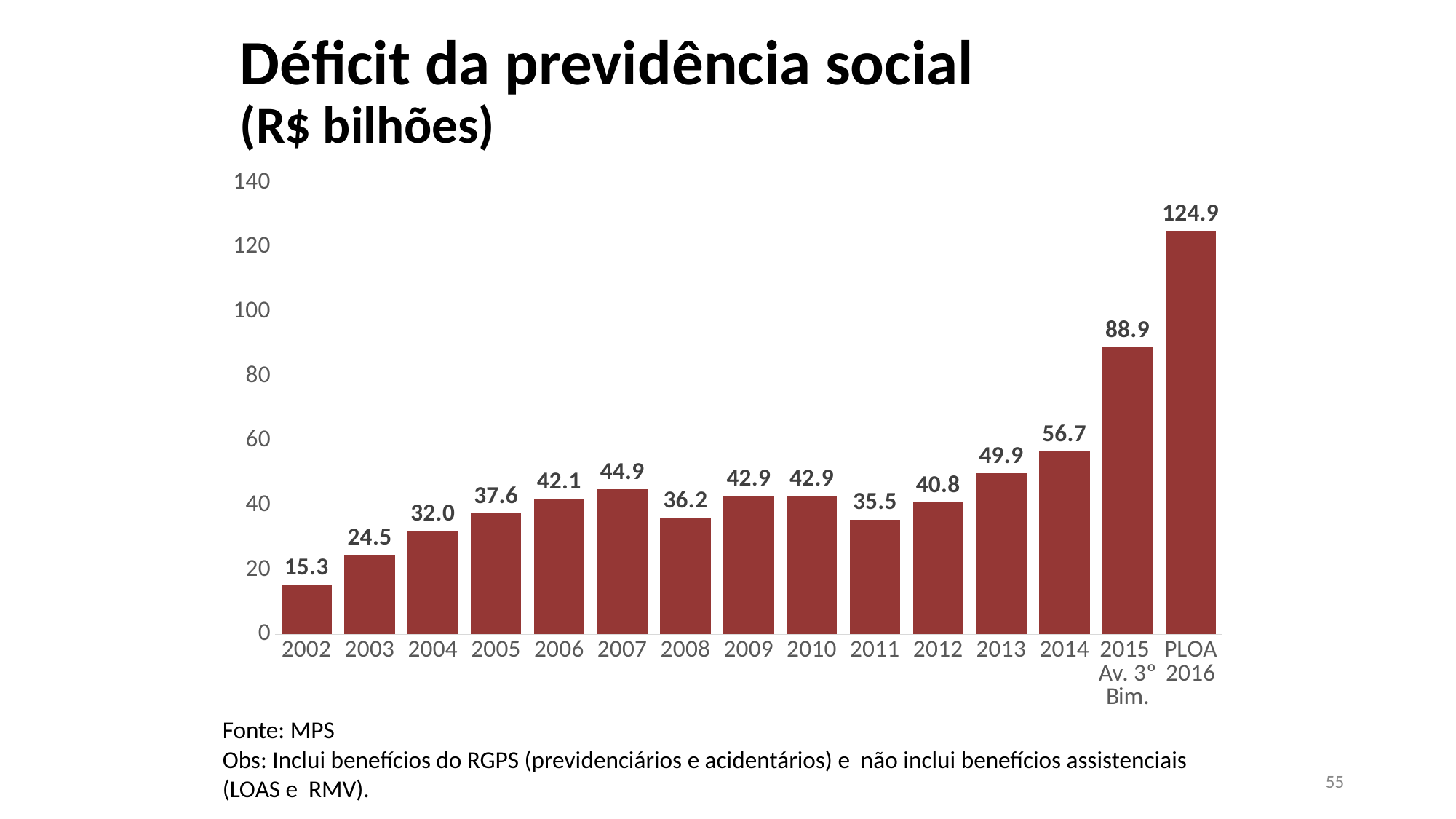
Is the value for 2014 greater or less than 60? less Which category has the lowest value? 2002 What kind of chart is shown on the slide? bar chart What is the difference between the values for PLOA 2016 and 2015 Av. 3° Bim.? 36.0 What is the value for 2015 Av. 3° Bim.? 88.9 Do the values rise or fall from 2012 to PLOA 2016? rise How many bars are shown in the chart? 15 What is the value for PLOA 2016? 124.9 Which category has the highest value? PLOA 2016 What is the title of the chart? Déficit da previdência social (R$ bilhões) Which is larger, the value for 2007 or the value for 2008? 2007 What is the value for 2002? 15.3